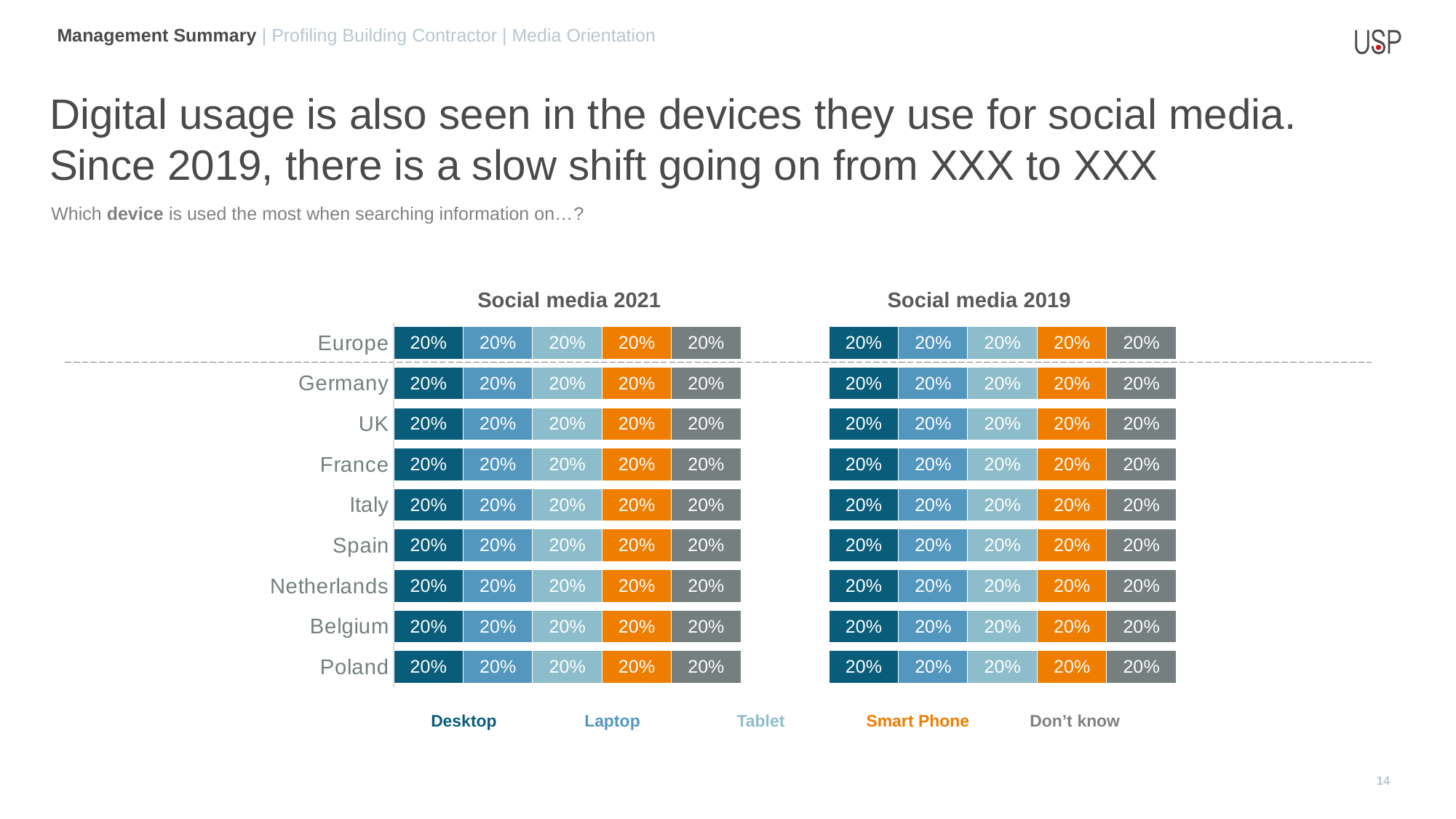
In the Social media 2019 chart, what is the Don't know value for Italy? 20% In the Social media 2021 chart, what is the Tablet value for Europe? 20% Which series is shown in orange in the legend? Smart Phone What is the title of the chart on the right side of the slide? Social media 2019 In the Social media 2021 chart, what is the Desktop value for Germany? 20% In the Social media 2019 chart, what is the difference between the Desktop and Laptop values for Spain? 0% How many countries or regions are listed as categories in the Social media 2021 chart? 9 What kind of chart is the Social media 2019 chart? Stacked bar chart In the Social media 2021 chart, what is the Laptop value for Netherlands? 20% In the Social media 2019 chart, what is the Smart Phone value for Poland? 20% In the Social media 2021 chart, what is the total of the stacked bar for France? 100% How many series does the legend list for the charts? 5